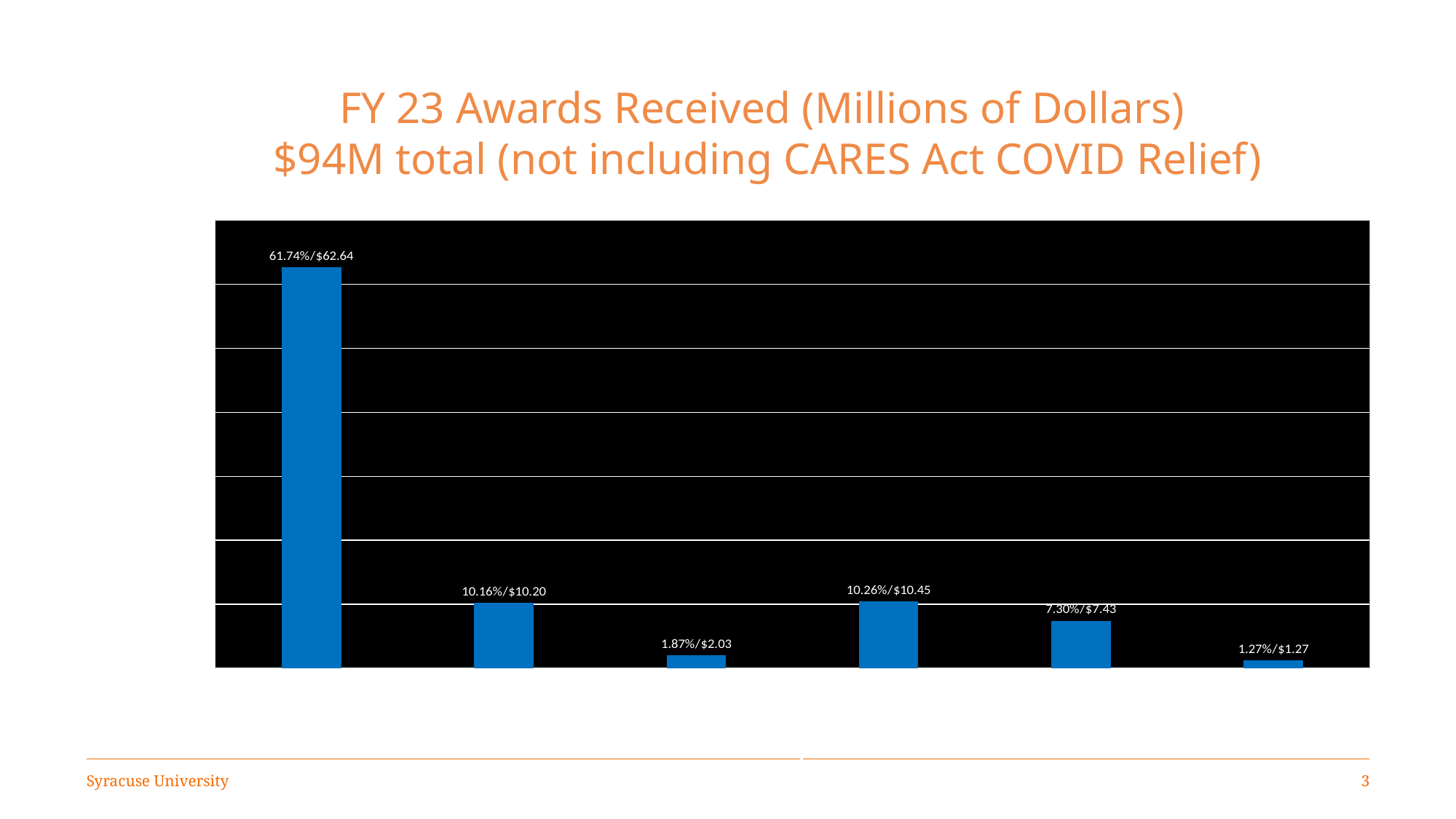
What is the dollar value shown on the second bar from the left? $10.20 What is the data label on the tallest bar in the chart? 61.74%/$62.64 Which bar has the larger value, the second bar from the left or the fifth bar from the left? the second bar from the left What is the dollar value shown on the third bar from the left? $2.03 What is the data label on the fifth bar from the left? 7.30%/$7.43 How many bars are plotted in the chart? 6 What is the difference in dollar value between the first bar ($62.64) and the second bar ($10.20)? $52.44 What total amount does the chart title state for FY 23 awards received? $94M What percentage is shown on the fourth bar from the left? 10.26% What is the data label on the shortest bar in the chart? 1.27%/$1.27 What kind of chart is shown on the slide? bar chart What is the difference in dollar value between the fourth bar ($10.45) and the fifth bar ($7.43)? $3.02